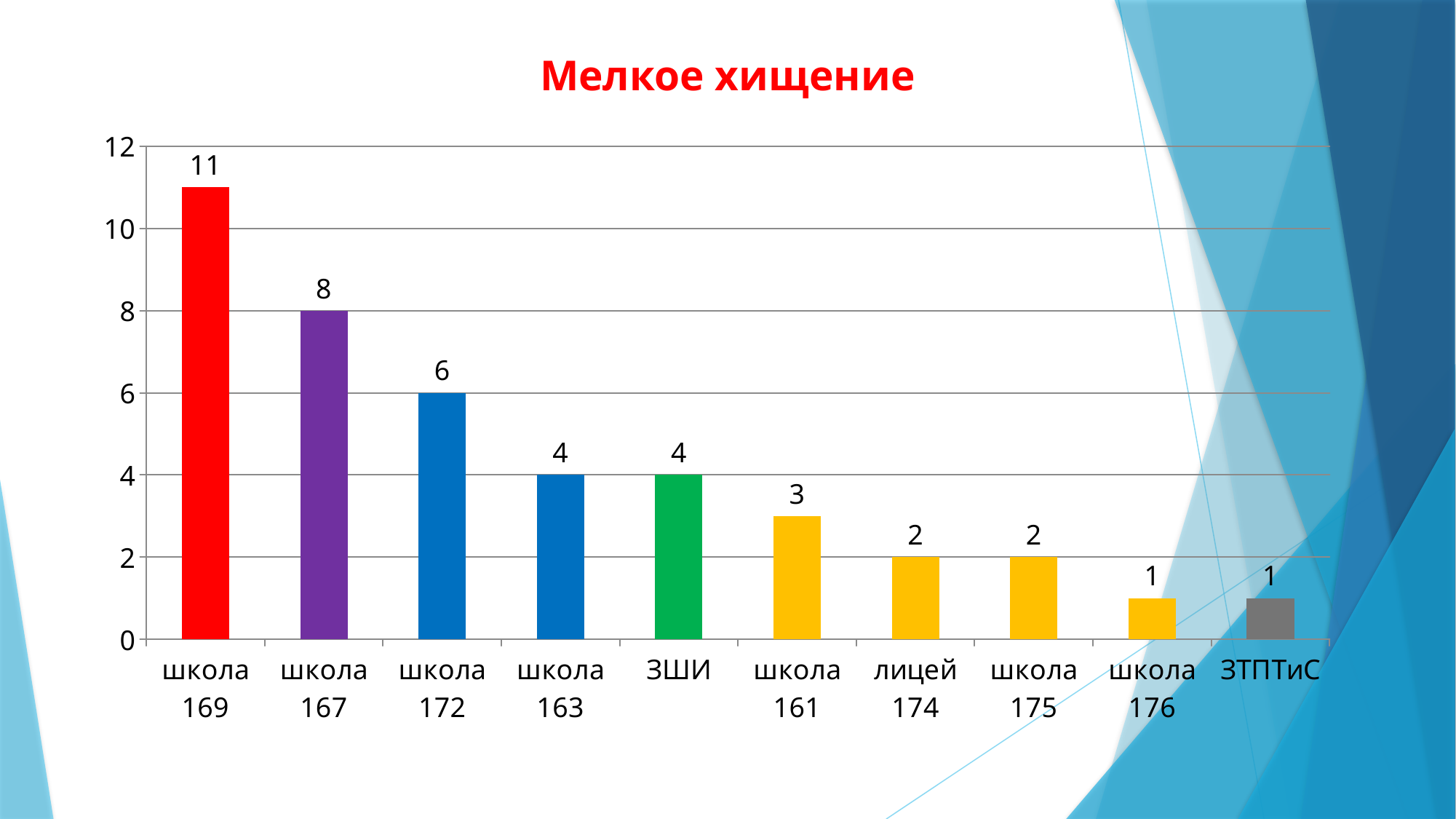
What is the value for школа 172? 6 What is the value for лицей 174? 2 Which category has the highest value? школа 169 What is the value for школа 169? 11 What is the difference between the values for школа 169 and школа 167? 3 What is the value for ЗШИ? 4 What is the title of the chart? Мелкое хищение What is the difference between the values for школа 172 and школа 161? 3 Which is larger, the value for школа 167 or the value for школа 163? школа 167 What kind of chart is this? bar chart How many categories are shown on the x axis? 10 Do the values rise or fall from left to right along the x axis? fall